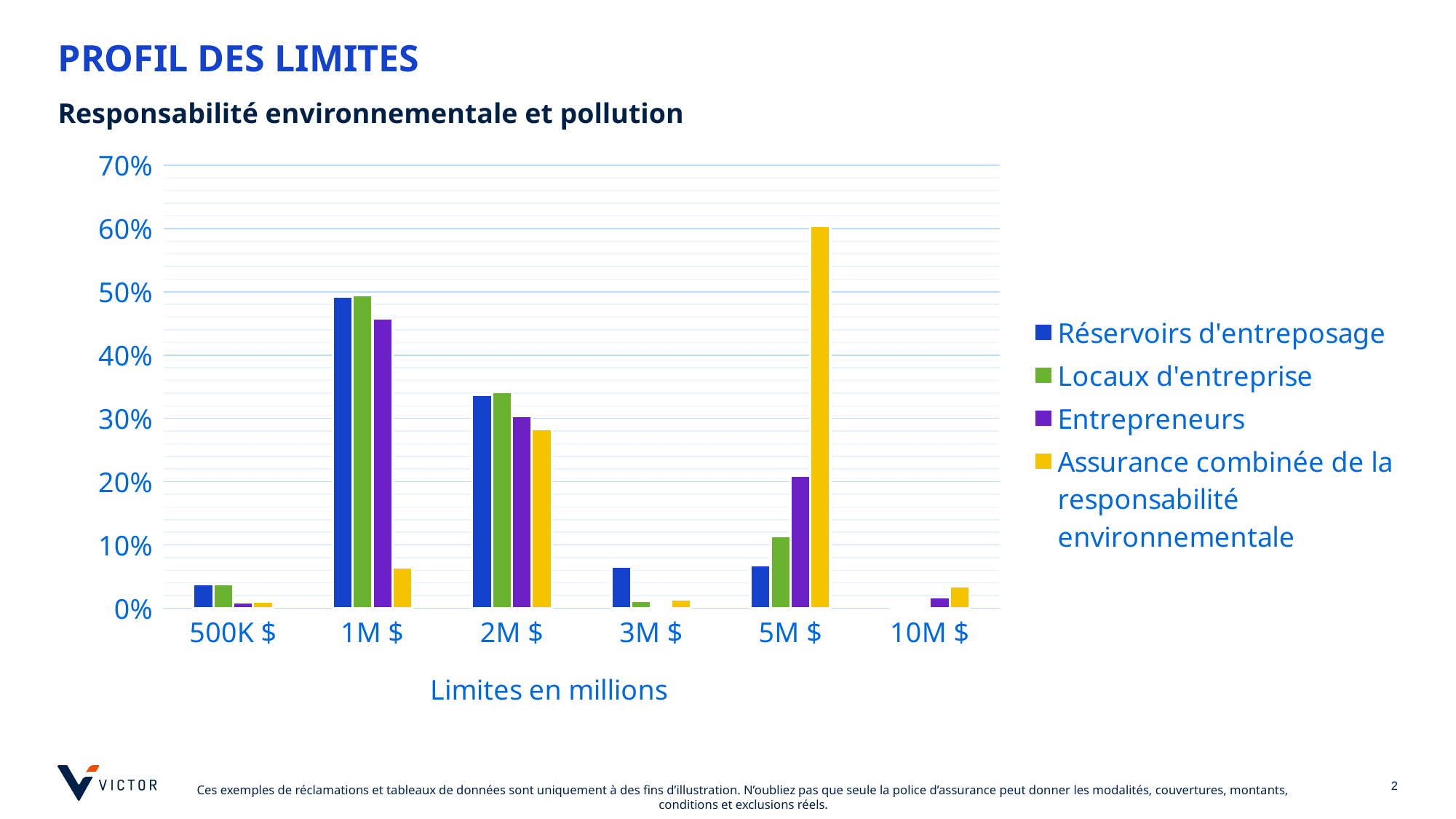
Is the value for Entrepreneurs at 2M $ greater or less than 20%? greater At 5M $, which is larger: Entrepreneurs or Locaux d'entreprise? Entrepreneurs Is the value for Locaux d'entreprise at 5M $ greater or less than 20%? less At 2M $, which is larger: Réservoirs d'entreposage or Assurance combinée de la responsabilité environnementale? Réservoirs d'entreposage What kind of chart is shown on the slide? Bar chart How many series does the legend list? 4 What is the title of the x axis? Limites en millions How many limit categories are shown on the x axis? 6 For the series Entrepreneurs, which limit has the highest value? 1M $ For the series Assurance combinée de la responsabilité environnementale, which limit has the highest value? 5M $ Is the value for Assurance combinée de la responsabilité environnementale at 5M $ greater or less than 50%? greater